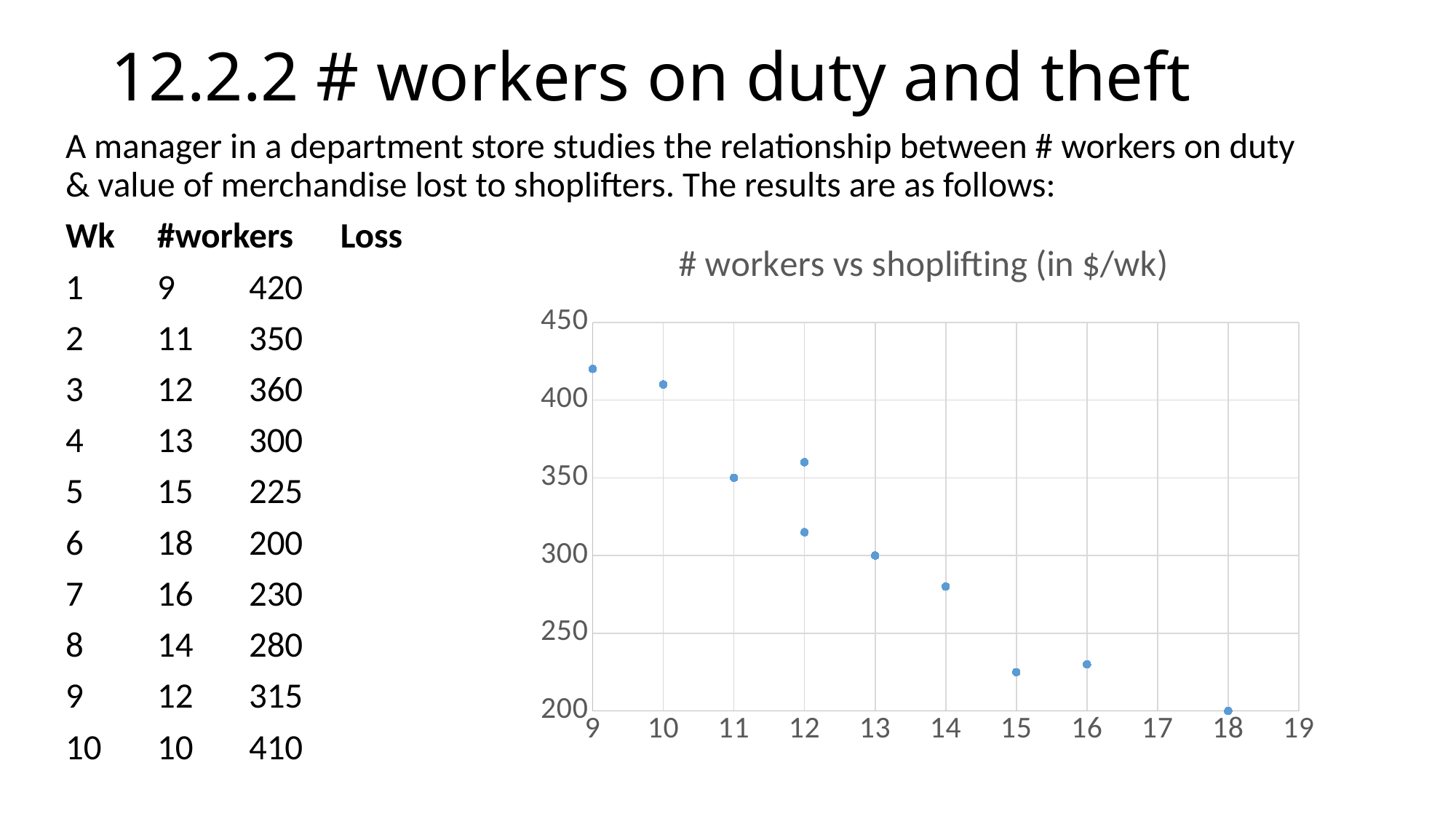
What is the difference between the loss at 9 workers and the loss at 18 workers? 220 What kind of chart is shown on the slide? scatter chart What is the loss value plotted for 18 workers? 200 At which number of workers is the plotted loss highest? 9 What is the loss value plotted for 11 workers? 350 How many data points are plotted in the chart? 10 What is the loss value plotted for 13 workers? 300 At which number of workers is the plotted loss lowest? 18 Is the loss value for 14 workers greater or less than 300? less Is the loss value for 10 workers greater or less than 400? greater What is the title of the chart? # workers vs shoplifting (in $/wk) Do the plotted loss values generally rise or fall as the number of workers increases along the x axis? fall